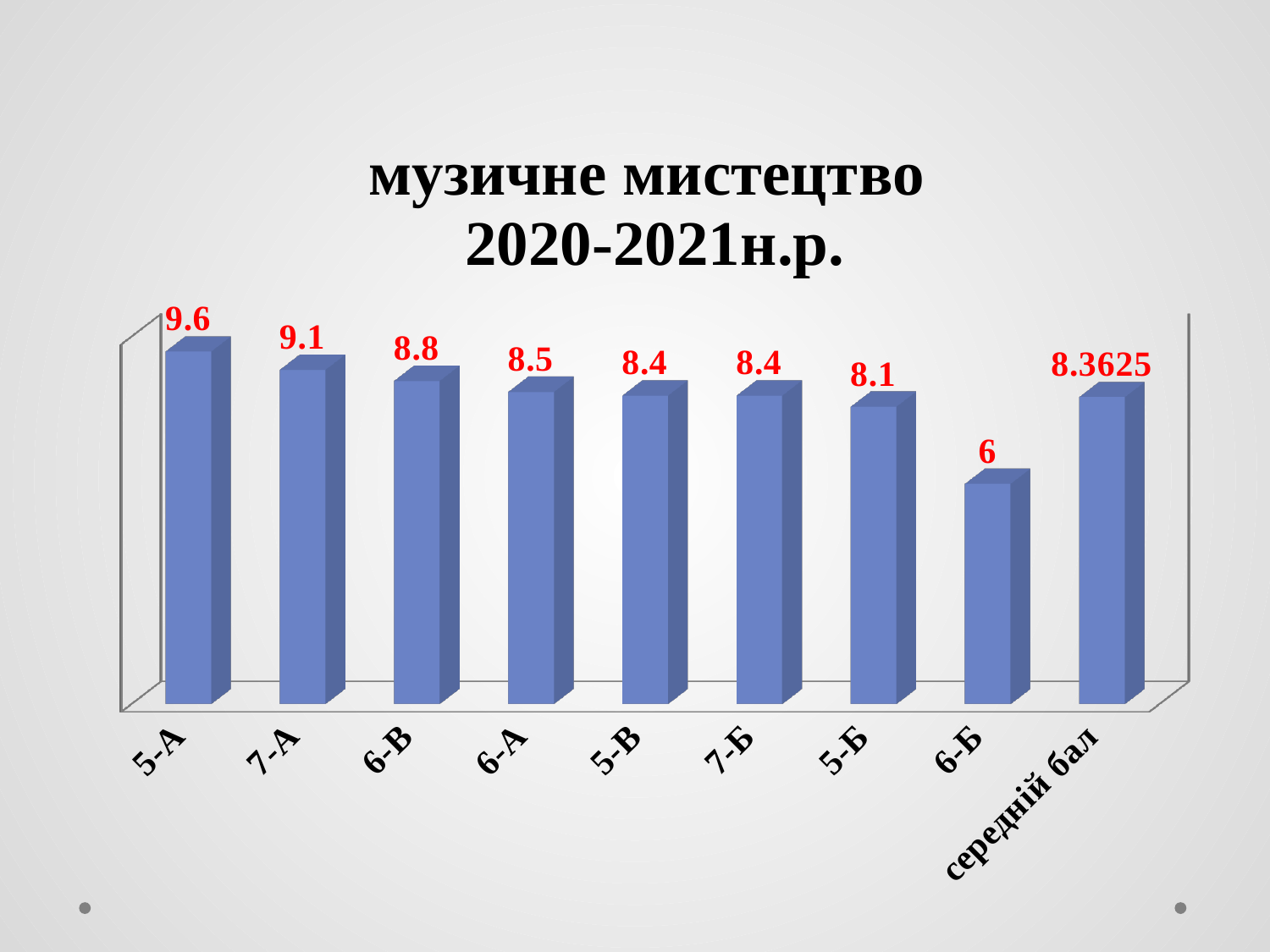
What is the title of the chart? музичне мистецтво 2020-2021н.р. Which is larger, the value for 6-В or the value for 5-Б? 6-В What is the value for 5-А? 9.6 What is the difference between the values for 5-А and 6-Б? 3.6 What is the value for 6-Б? 6 What is the value shown for середній бал? 8.3625 What is the value for 7-А? 9.1 What kind of chart is shown on the slide? bar chart Which category has the lowest value? 6-Б Which class has the highest value? 5-А What is the difference between the values for 7-А and 6-А? 0.6 How many bars are shown in the chart? 9